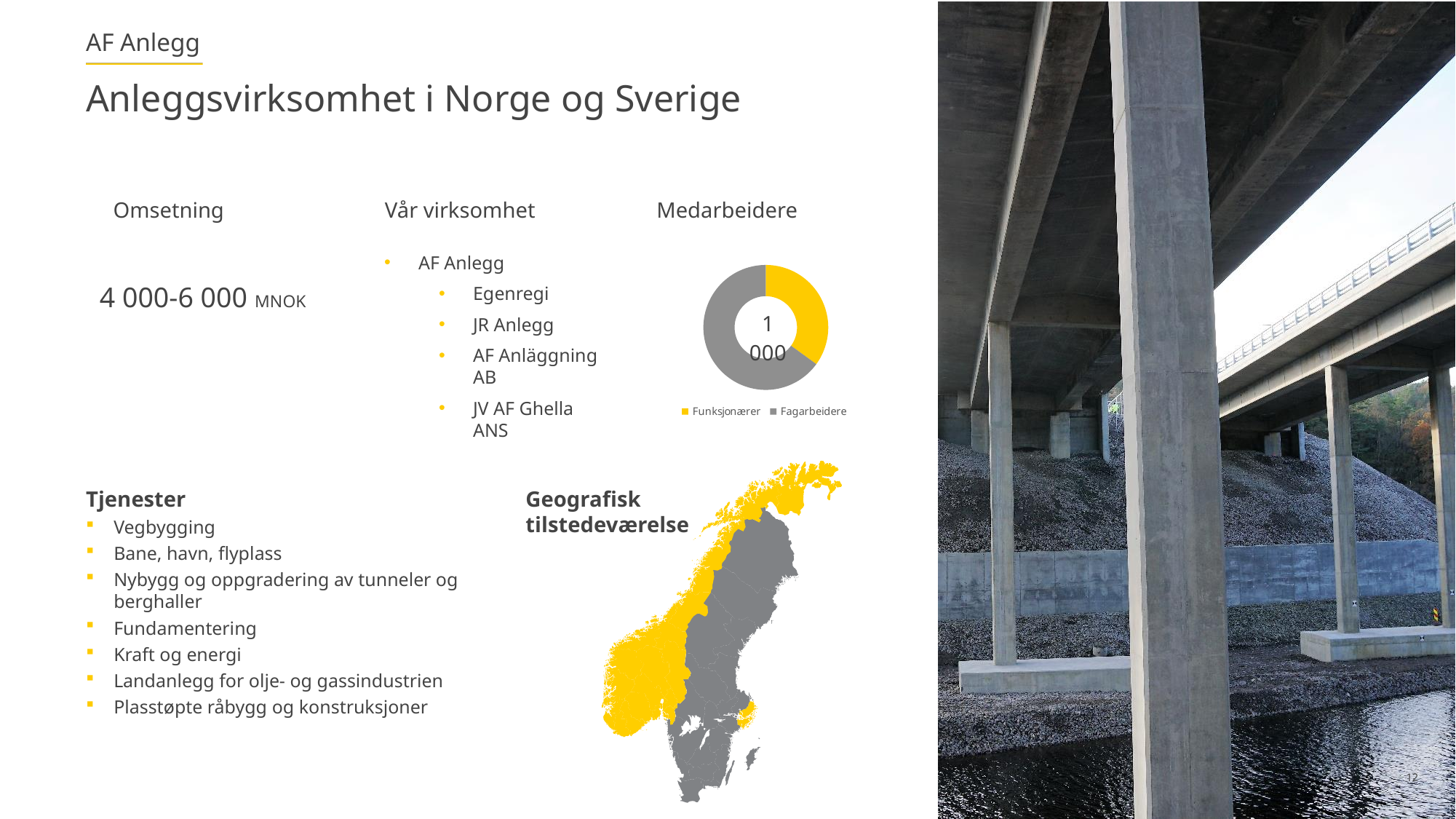
Which colour represents Fagarbeidere in the "Medarbeidere" chart? Grey How many categories does the legend of the "Medarbeidere" chart list? 2 What number is printed in the centre of the "Medarbeidere" doughnut chart? 1 000 Is the share of Fagarbeidere in the "Medarbeidere" chart greater or less than 50%? greater What kind of chart is shown under the heading "Medarbeidere"? Doughnut (pie) chart Which category has the largest share in the "Medarbeidere" chart? Fagarbeidere Which category has the smallest share in the "Medarbeidere" chart? Funksjonærer Which colour represents Funksjonærer in the "Medarbeidere" chart? Yellow Is the share of Funksjonærer in the "Medarbeidere" chart greater or less than 50%? less In the "Medarbeidere" chart, which is larger: Funksjonærer or Fagarbeidere? Fagarbeidere